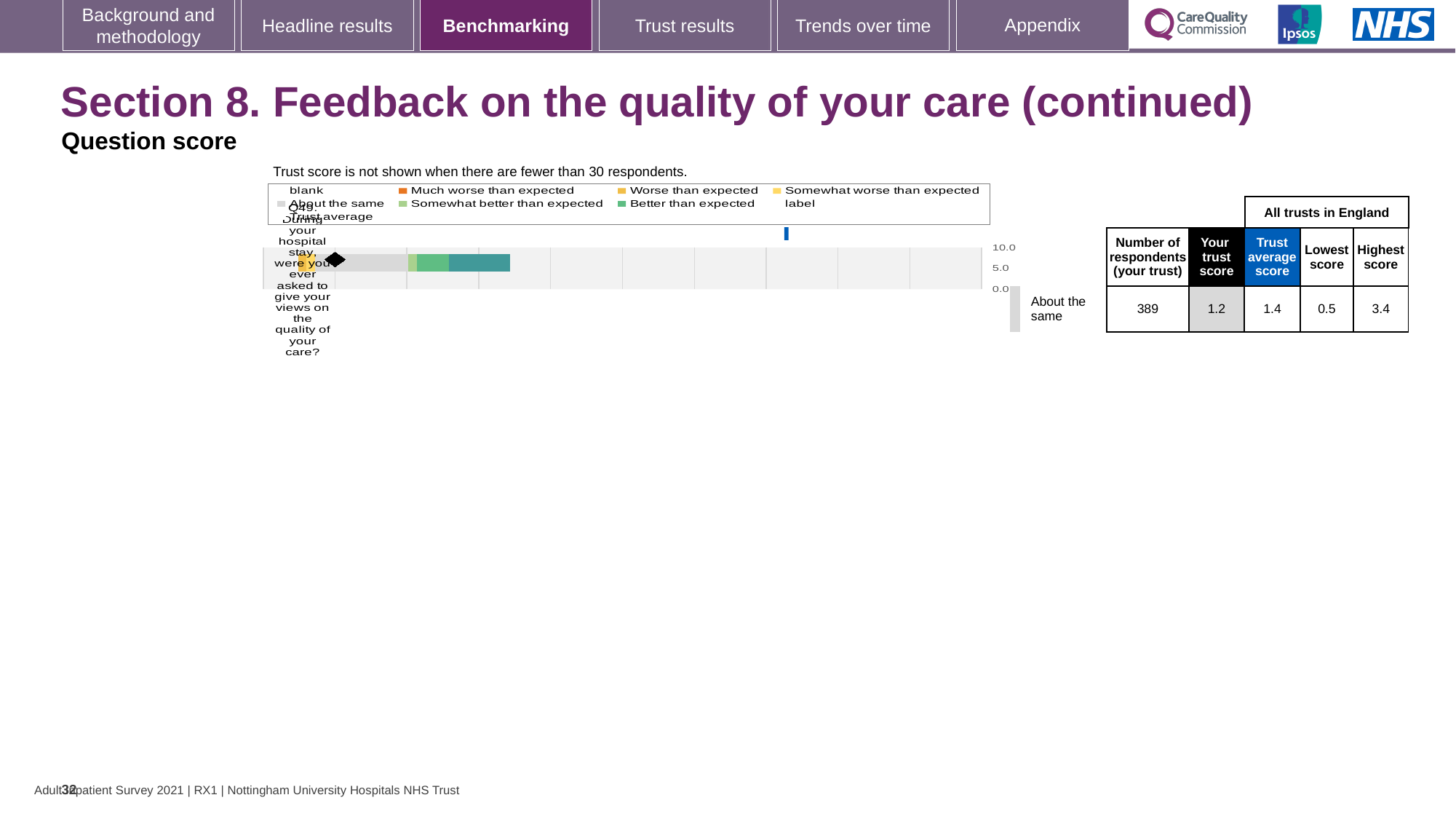
What is the trust average score for Q49 shown in the table beside the chart? 1.4 What is the lowest score across all trusts in England for Q49? 0.5 What is the difference between the highest score and the lowest score for Q49? 2.9 How many respondents from the trust answered Q49? 389 How many questions (categories) are plotted in the chart? 1 What kind of chart is shown on the slide? bar chart What is the trust score for Q49 shown in the table beside the chart? 1.2 What is the highest score across all trusts in England for Q49? 3.4 Which is larger for Q49, the trust score or the trust average score? trust average score Which question number is plotted in the chart? Q49 What is the difference between the trust average score and the trust score for Q49? 0.2 What is the benchmark rating shown for Q49 next to the chart? About the same